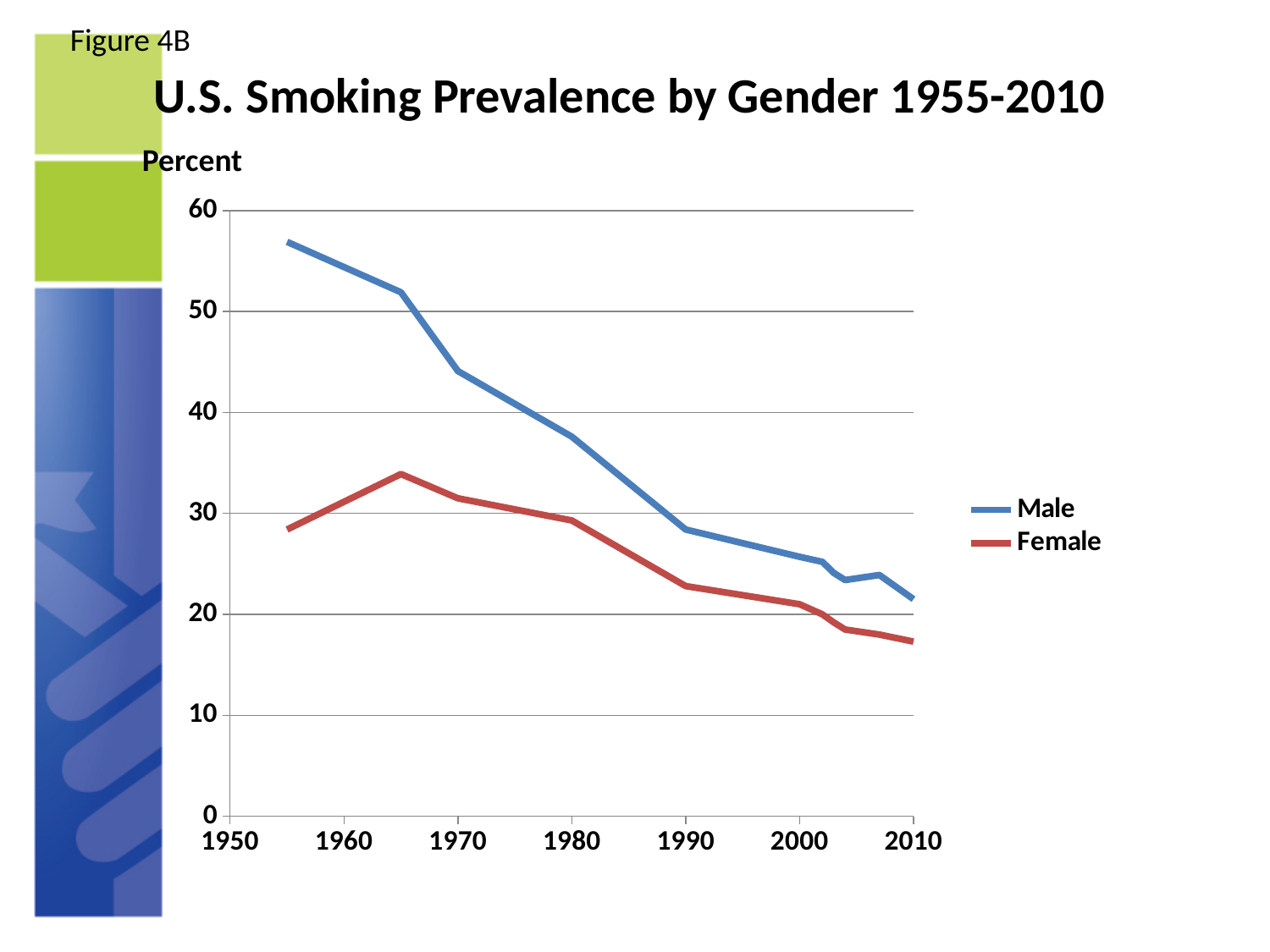
Is the value for Male in 1970 greater or less than 40? greater What kind of chart is shown on the slide? line chart Which is larger for Female: the value in 1955 or the value in 1965? 1965 In which year does the Female line reach its highest value? 1965 How many series does the legend list? 2 Is the value for Female in 2010 greater or less than 20? less Is the value for Male in 1955 greater or less than 50? greater Does the Male line rise or fall from 1955 to 2010? fall In 1980, which series has the higher value, Male or Female? Male What is the title of the chart? U.S. Smoking Prevalence by Gender 1955-2010 What label is shown on the vertical axis of the chart? Percent